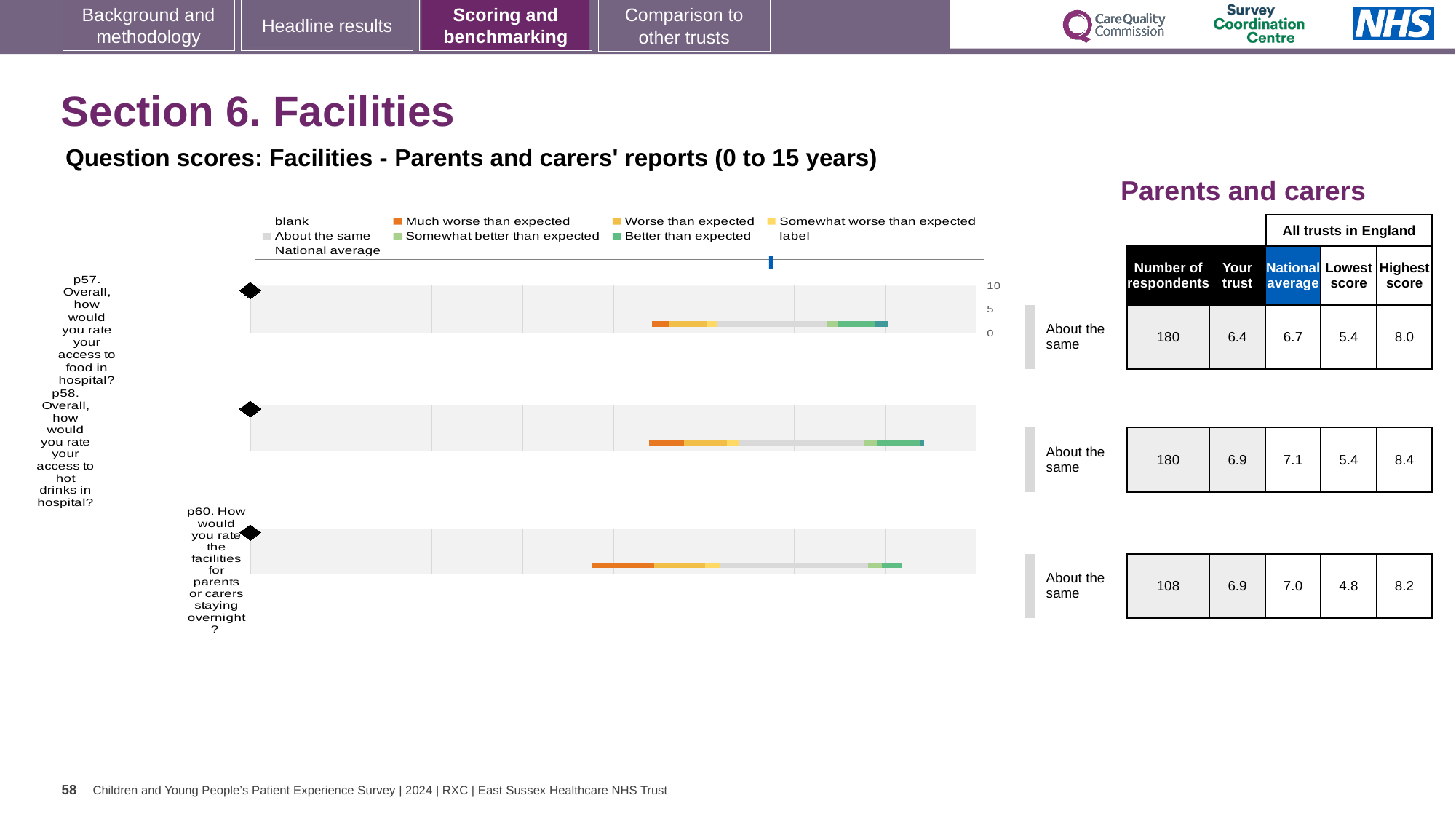
What is the national average score for p58 (access to hot drinks in hospital)? 7.1 What benchmark category is shown for p57? About the same What is the difference between the highest score and the lowest score for p58? 3.0 What is the 'Your trust' score for p57 (access to food in hospital)? 6.4 Which question has the lowest 'Lowest score' across all trusts in England? p60 What is the maximum value shown on the score axis of the charts? 10 How many respondents answered p60 (facilities for parents or carers staying overnight)? 108 For p57, which is larger: the 'Your trust' score or the national average? National average How many questions (p57, p58, p60) are plotted on the slide? 3 What is the difference between the national average and the 'Your trust' score for p60? 0.1 Which question has the highest 'Highest score' across all trusts in England? p58 What kind of chart is used to show the question scores for p57, p58 and p60? bar chart